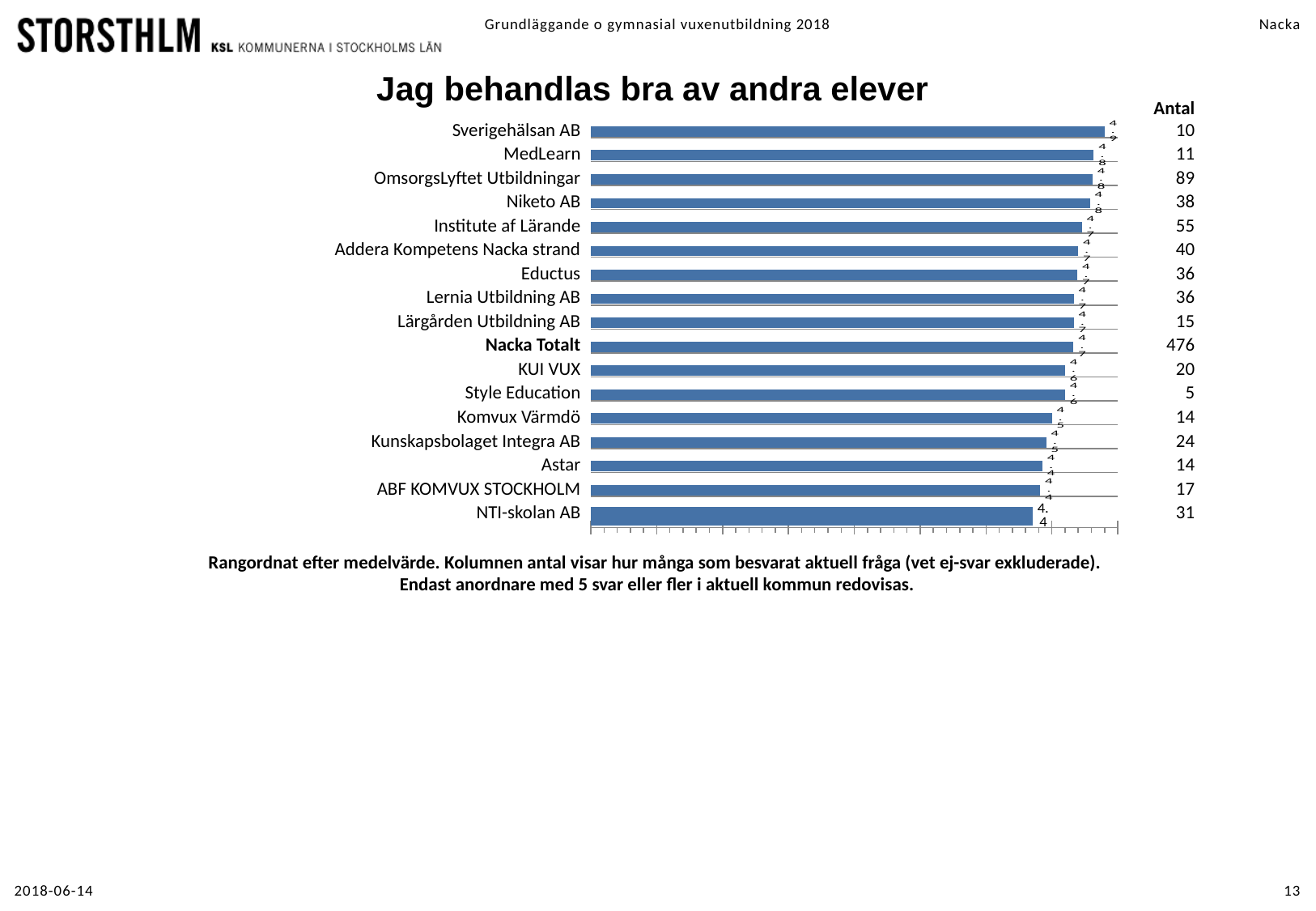
Which category has the highest value in the chart? Sverigehälsan AB What is the value for Nacka Totalt? 4.7 According to the Antal column, how many respondents answered for Nacka Totalt? 476 Which has a larger value, Sverigehälsan AB or NTI-skolan AB? Sverigehälsan AB Do the bar values increase or decrease going from the top of the chart to the bottom? decrease How many categories (providers) are shown in the chart? 17 What is the title of the chart? Jag behandlas bra av andra elever What is the value for Sverigehälsan AB? 4.9 What kind of chart is shown on the slide? bar chart What is the difference between the values for Sverigehälsan AB and NTI-skolan AB? 0.5 What is the value for NTI-skolan AB? 4.4